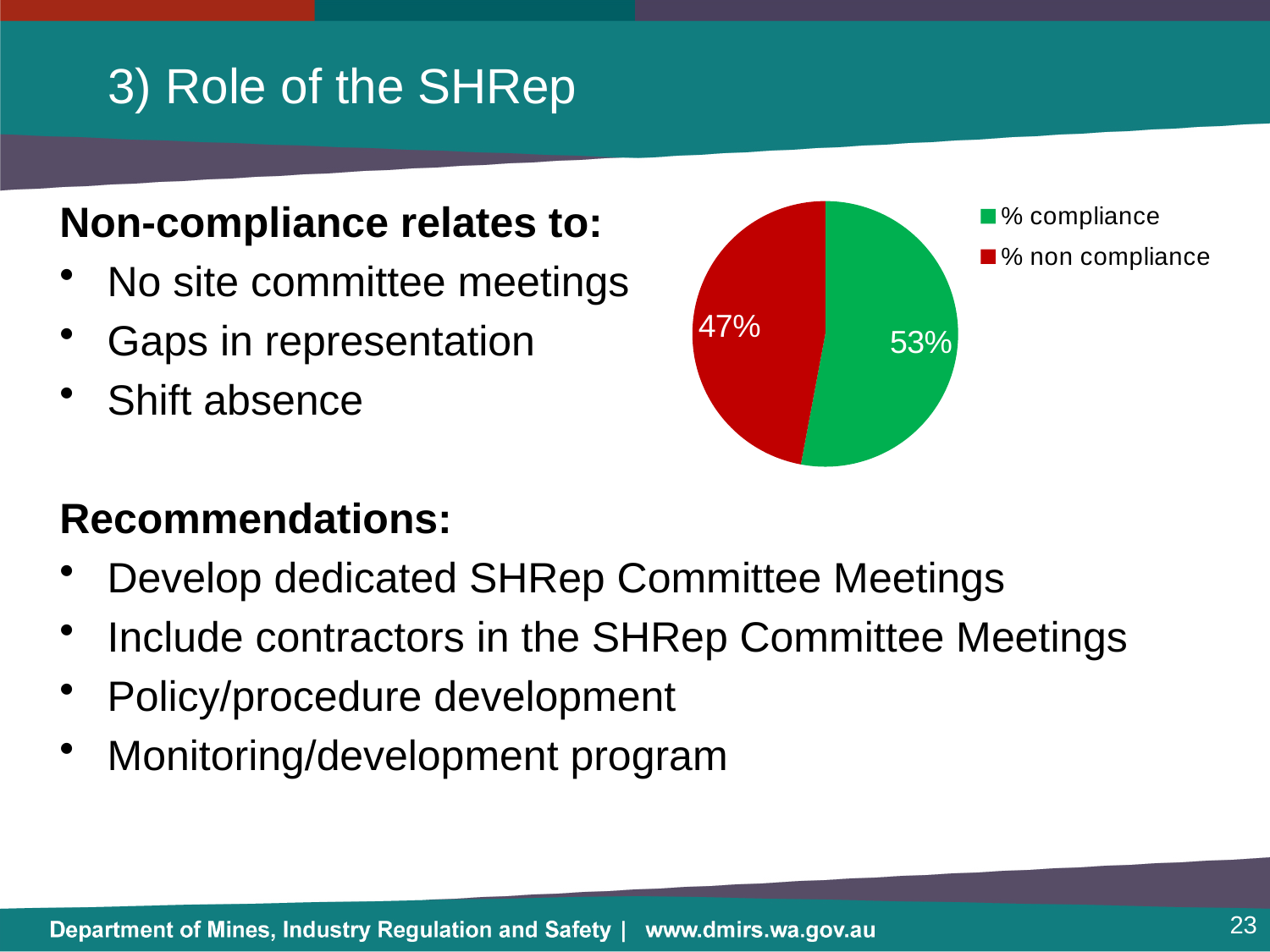
Which is larger, % compliance or % non compliance? % compliance What type of chart is shown on the slide? pie chart What is the difference between the % compliance and % non compliance slices? 6% What share of the pie does the % compliance slice represent? 53% What is the value for % compliance in the pie chart? 53% What is the value for % non compliance in the pie chart? 47% Which slice of the pie chart is the smallest? % non compliance What colour is the % non compliance slice in the pie chart? red Which slice of the pie chart is the largest? % compliance How many slices does the pie chart have? 2 What colour is the % compliance slice in the pie chart? green How many entries does the legend of the pie chart list? 2